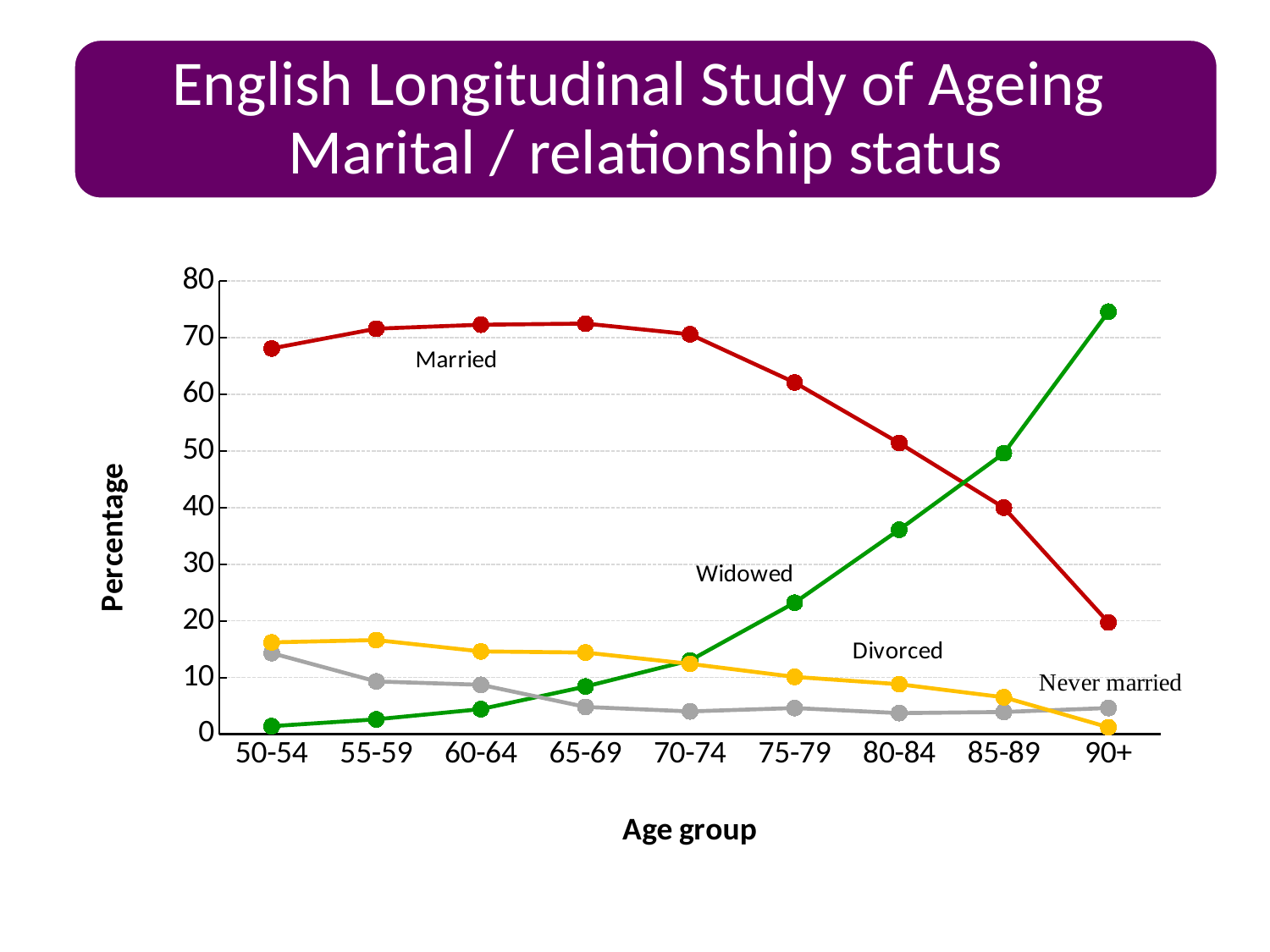
How many marital status series are plotted on the chart? 4 In which age group is the Widowed percentage highest? 90+ What kind of chart is shown on the slide? Line chart Is the Widowed value for the 90+ age group greater or less than 70? greater Is the Married value for the 90+ age group greater or less than 30? less What is the label on the vertical axis? Percentage In which age group is the Married percentage lowest? 90+ How many age groups are shown on the x axis? 9 Does the Widowed percentage rise or fall as age group increases? Rises Is the Married value for the 50-54 age group greater or less than 60? greater In which age group is the Widowed percentage lowest? 50-54 For the 85-89 age group, which is larger: the Widowed percentage or the Married percentage? Widowed